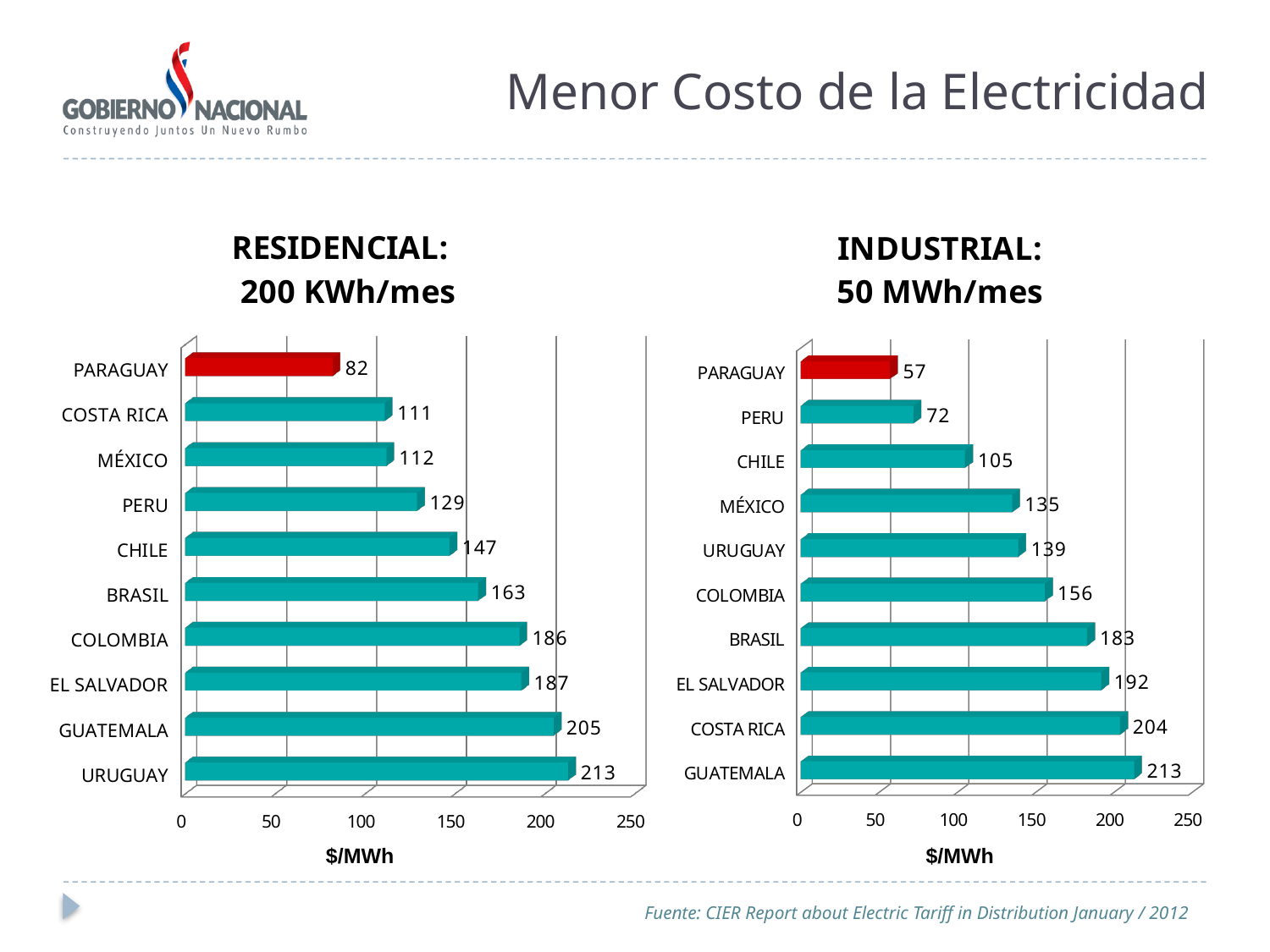
How many countries are shown in the RESIDENCIAL: 200 KWh/mes chart? 10 In the INDUSTRIAL: 50 MWh/mes chart, which country has the lowest value? PARAGUAY In the INDUSTRIAL: 50 MWh/mes chart, is the value for MÉXICO greater or less than 100? greater What type of chart is the INDUSTRIAL: 50 MWh/mes chart? bar chart In the RESIDENCIAL: 200 KWh/mes chart, what is the value for PARAGUAY? 82 In the RESIDENCIAL: 200 KWh/mes chart, what is the difference between CHILE and PERU? 18 In the INDUSTRIAL: 50 MWh/mes chart, what is the value for COSTA RICA? 204 In the RESIDENCIAL: 200 KWh/mes chart, which country has the highest value? URUGUAY In the INDUSTRIAL: 50 MWh/mes chart, what is the difference between GUATEMALA and PARAGUAY? 156 In the INDUSTRIAL: 50 MWh/mes chart, what is the value for PERU? 72 In the RESIDENCIAL: 200 KWh/mes chart, which is larger, BRASIL or COLOMBIA? COLOMBIA What unit is shown on the x axis of both charts? $/MWh